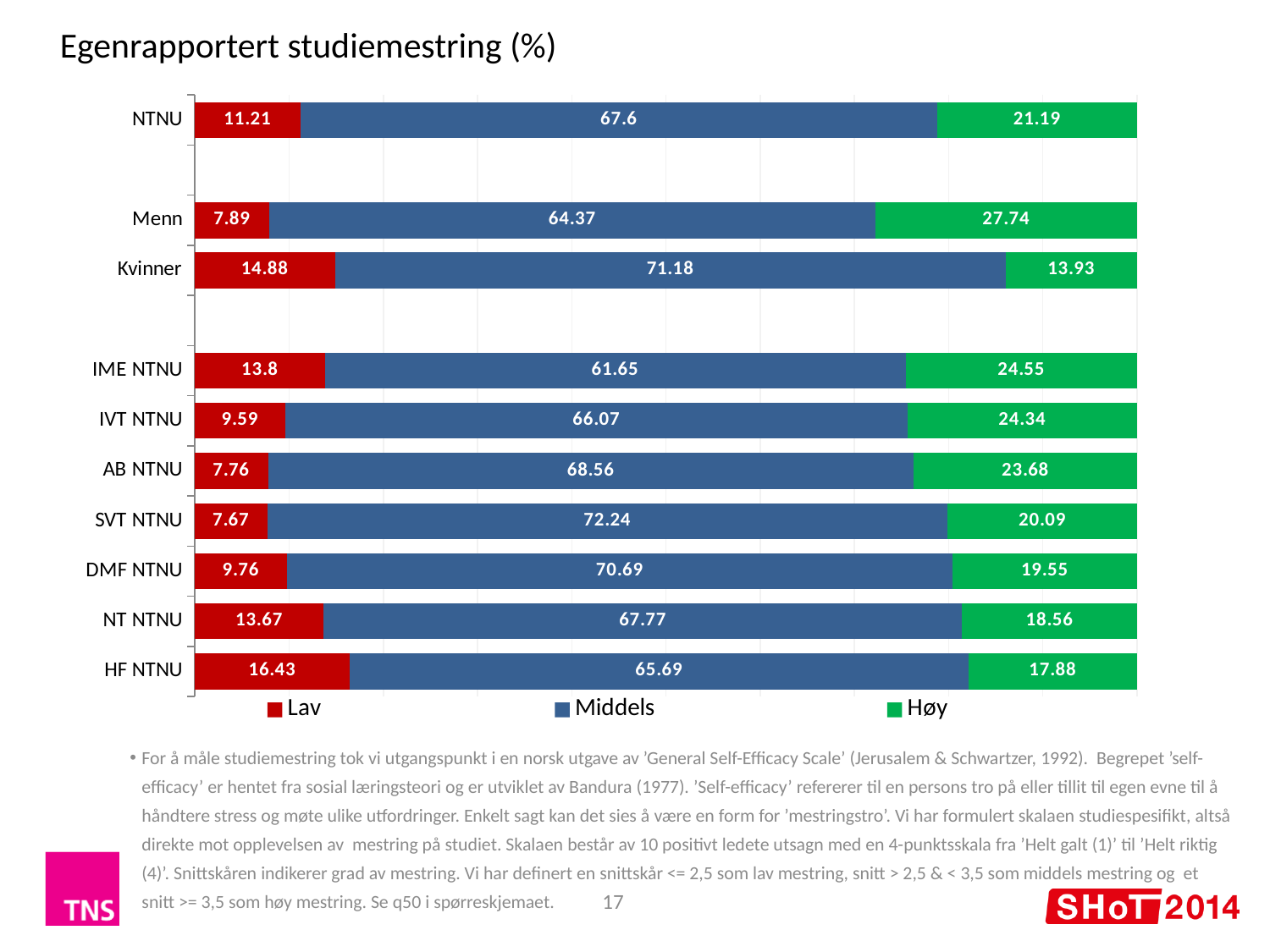
Which category has the highest Middels value? SVT NTNU What is the total of the stacked bar for NTNU? 100 What is the Lav value for HF NTNU? 16.43 How many series does the legend list? 3 What kind of chart is shown on the slide? Stacked bar chart What is the Middels value for SVT NTNU? 72.24 How many categories are shown on the chart? 10 Which is larger, the Høy value for IME NTNU or for NT NTNU? IME NTNU Which category has the lowest Høy value? Kvinner Which category has the highest Lav value? HF NTNU What is the Høy value for Menn? 27.74 What is the difference between the Høy values for Menn and Kvinner? 13.81